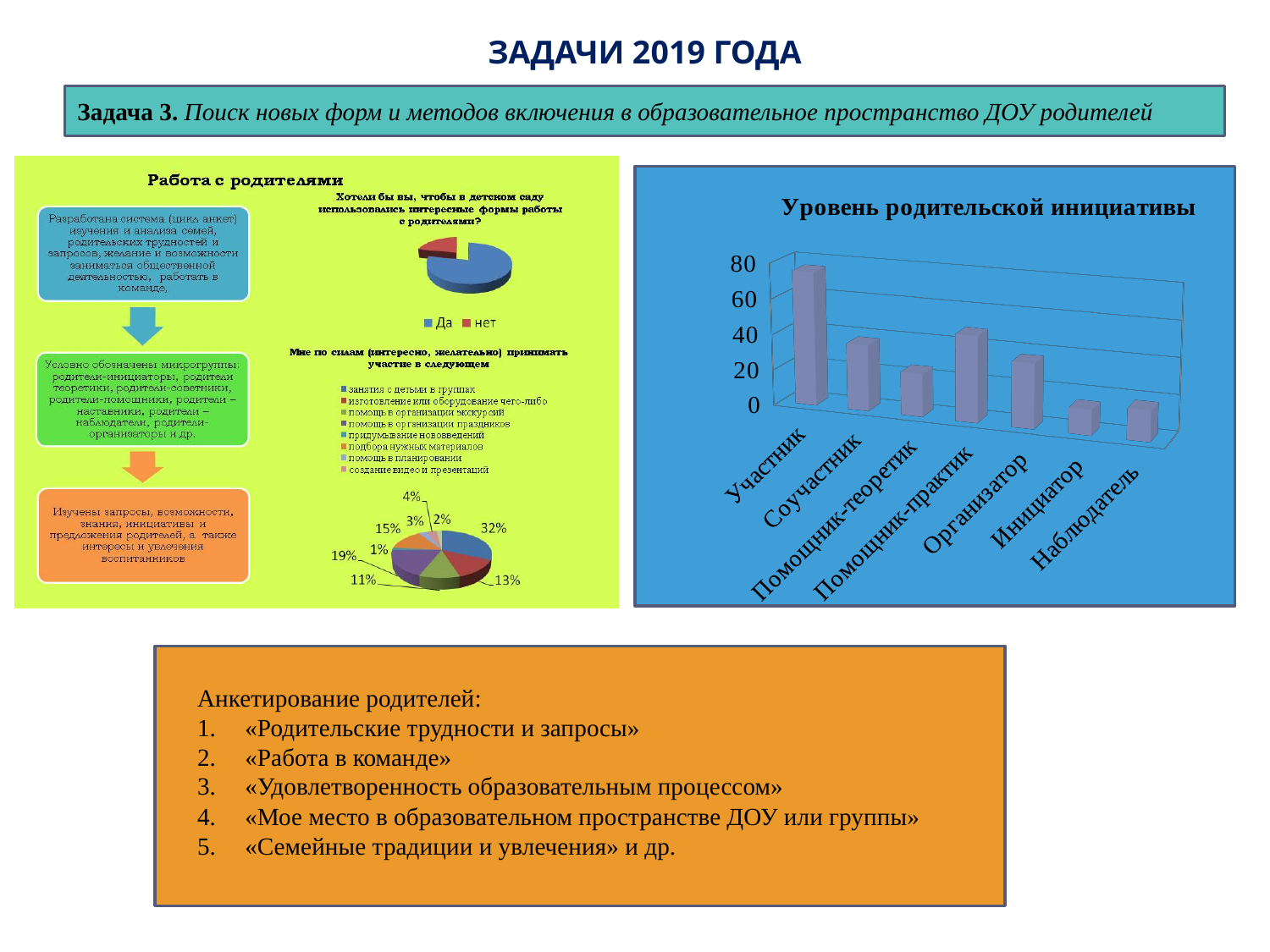
In the "Уровень родительской инициативы" chart, which is larger: Помощник-практик or Помощник-теоретик? Помощник-практик What kind of chart is "Уровень родительской инициативы"? bar chart In the lower pie chart on the left ("Мне по силам ... принимать участие в следующем"), what is the share of the largest slice? 32% In the "Уровень родительской инициативы" chart, is the value for Инициатор greater or less than 20? less In the "Уровень родительской инициативы" chart, which is larger: Организатор or Инициатор? Организатор In the "Уровень родительской инициативы" chart, is the value for Помощник-практик greater or less than 20? greater In the "Уровень родительской инициативы" chart, is the value for Участник greater or less than 60? greater How many categories are shown on the x axis of the "Уровень родительской инициативы" chart? 7 What is the highest tick value shown on the vertical axis of the "Уровень родительской инициативы" chart? 80 In the pie chart on the left titled "Хотели бы вы, чтобы в детском саду использовались интересные формы работы с родителями?", how many entries does the legend list? 2 In the "Уровень родительской инициативы" chart, which category has the highest value? Участник